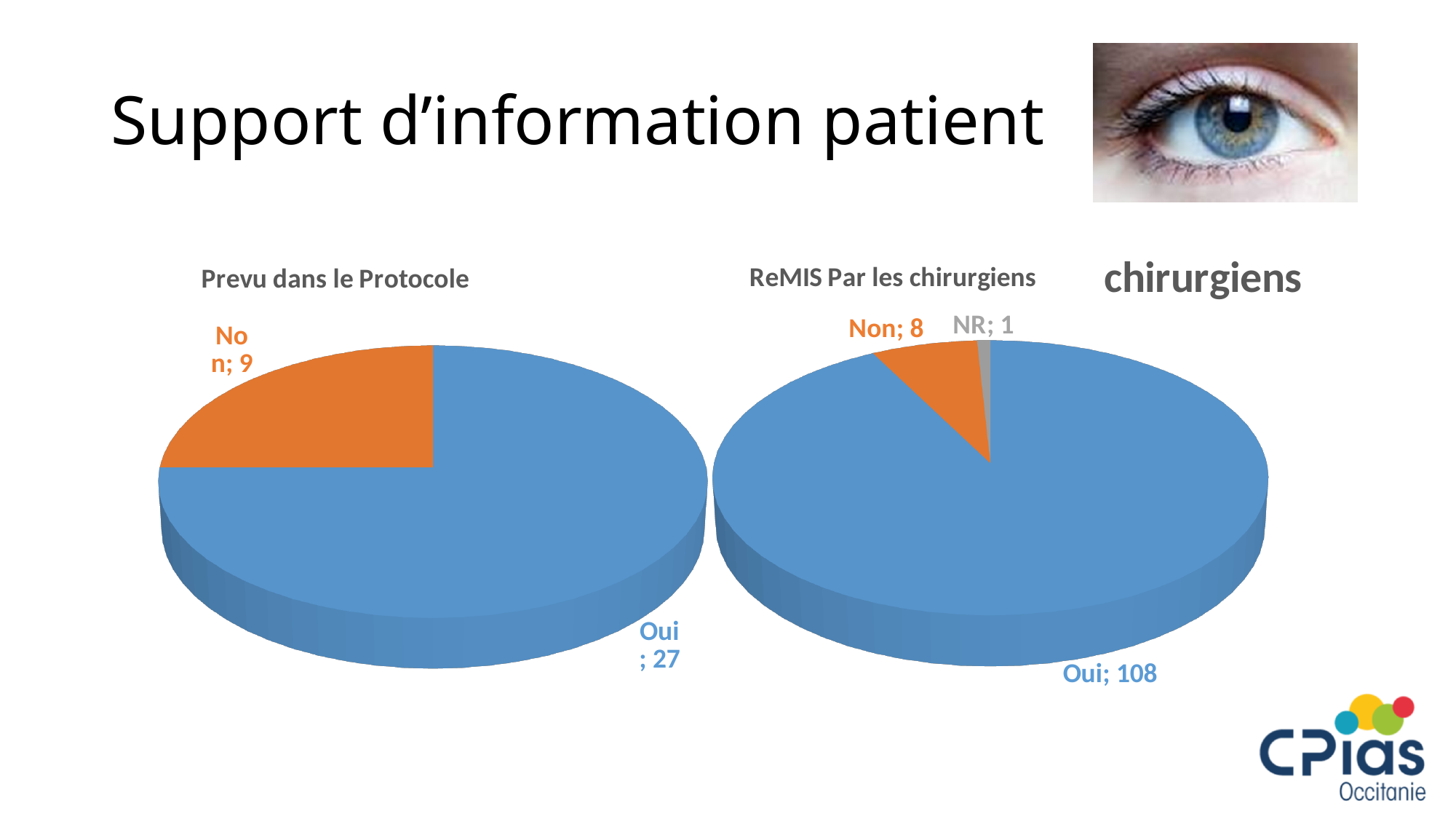
In the 'ReMIS Par les chirurgiens' chart, what is the value for NR? 1 In the 'ReMIS Par les chirurgiens' chart, what colour is the Oui slice? Blue In the 'Prevu dans le Protocole' chart, what is the value for Oui? 27 In the 'ReMIS Par les chirurgiens' chart, what is the difference between Oui and Non? 100 In the 'ReMIS Par les chirurgiens' chart, what is the value for Oui? 108 In the 'ReMIS Par les chirurgiens' chart, which category has the smallest slice? NR How many slices does the 'ReMIS Par les chirurgiens' chart have? 3 In the 'Prevu dans le Protocole' chart, what share of the pie does Non represent? 25% In the 'Prevu dans le Protocole' chart, what is the value for Non? 9 In the 'Prevu dans le Protocole' chart, which category has the largest slice? Oui In the 'Prevu dans le Protocole' chart, what is the difference between Oui and Non? 18 What kind of chart is the 'Prevu dans le Protocole' chart? Pie chart